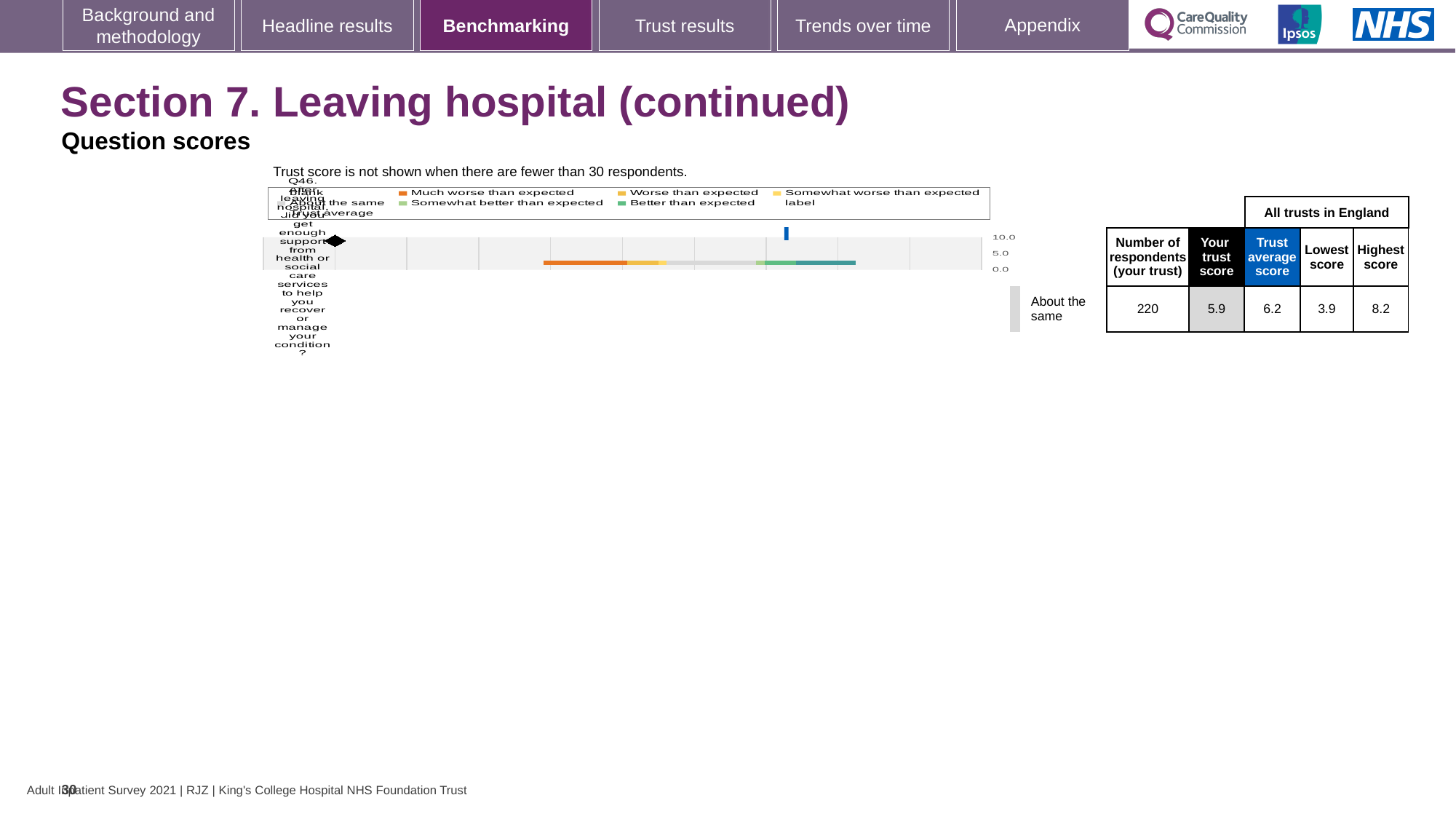
Which is larger for Q46: your trust score or the trust average score? Trust average score According to the table next to the chart, what is the trust average score for Q46? 6.2 Which legend entry in the chart is shown in orange? Much worse than expected According to the table next to the chart, what is the number of respondents for your trust for Q46? 220 What benchmark category label is shown to the right of the chart for Q46? About the same What is the difference between the trust average score and your trust score for Q46? 0.3 What is the highest tick value shown on the chart's axis? 10.0 What kind of chart is shown on the slide? bar chart According to the table next to the chart, what is the highest score among all trusts in England for Q46? 8.2 What is the difference between the highest score and the lowest score for Q46 in the table next to the chart? 4.3 According to the table next to the chart, what is the lowest score among all trusts in England for Q46? 3.9 According to the table next to the chart, what is your trust score for Q46? 5.9